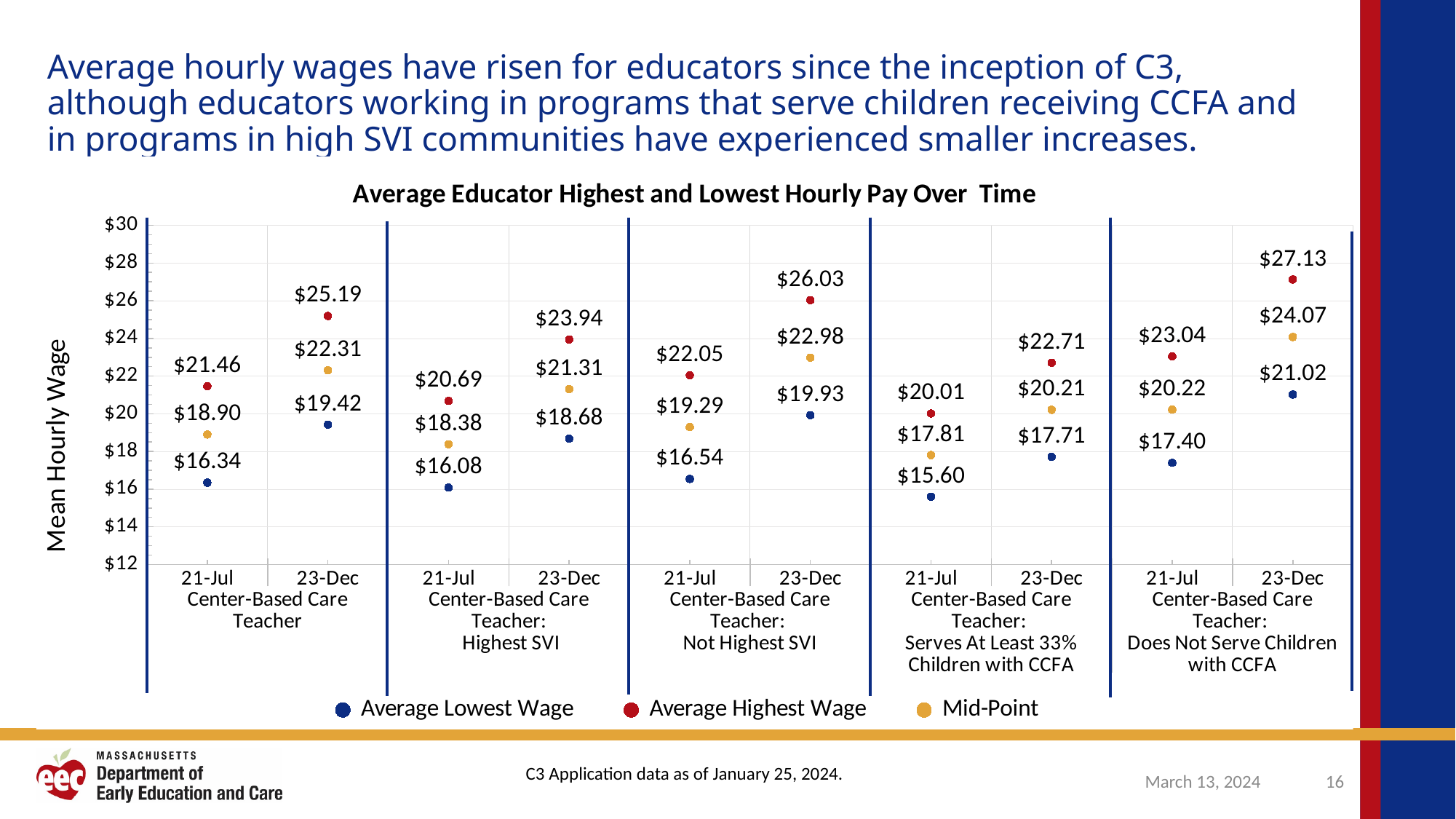
What is the title of the chart? Average Educator Highest and Lowest Hourly Pay Over Time Which is larger: the 23-Dec Average Lowest Wage for Highest SVI or for Not Highest SVI? Not Highest SVI What is the Mid-Point value for Center-Based Care Teacher: Highest SVI in 23-Dec? $21.31 What is the Average Highest Wage for Center-Based Care Teacher: Does Not Serve Children with CCFA in 23-Dec? $27.13 What is the Average Lowest Wage for Center-Based Care Teacher: Serves At Least 33% Children with CCFA in 21-Jul? $15.60 What is the Average Highest Wage for Center-Based Care Teacher: Not Highest SVI in 21-Jul? $22.05 Which group and period has the lowest Average Lowest Wage on the chart? Center-Based Care Teacher: Serves At Least 33% Children with CCFA, 21-Jul What is the difference between the Average Highest Wage and the Average Lowest Wage for Center-Based Care Teacher: Not Highest SVI in 23-Dec? $6.10 Which group and period has the highest Average Highest Wage on the chart? Center-Based Care Teacher: Does Not Serve Children with CCFA, 23-Dec How many series does the legend list? 3 Does the Average Lowest Wage for Center-Based Care Teacher: Does Not Serve Children with CCFA rise or fall from 21-Jul to 23-Dec? Rise By how much did the Average Highest Wage for Center-Based Care Teacher rise from 21-Jul to 23-Dec? $3.73